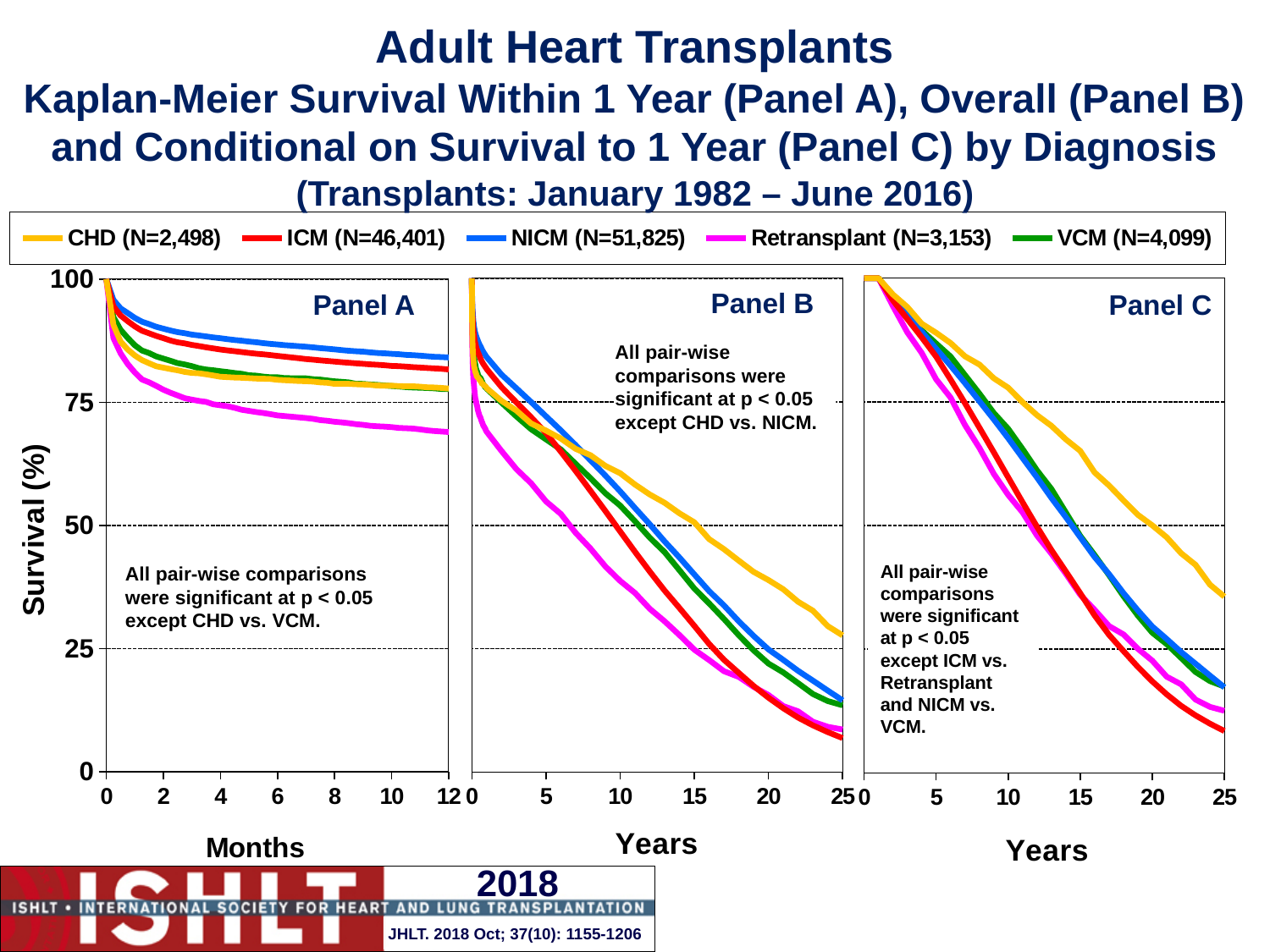
In Panel C, is the survival value for CHD at 25 years greater or less than 25? greater In Panel B, do the survival curves rise or fall along the x axis? fall In Panel B, is the survival value for ICM at 25 years greater or less than 25? less In Panel A, is the survival value for Retransplant at 12 months greater or less than 75? less In Panel A, which diagnosis group has the highest survival at 12 months? NICM What kind of chart is shown in Panel A? line chart How many series does the legend list? 5 What is the unit of the x axis in Panel A? Months In Panel A, which diagnosis group has the lowest survival at 12 months? Retransplant In Panel B, which diagnosis group has the highest survival at 25 years? CHD According to the legend, what is the N for ICM? 46,401